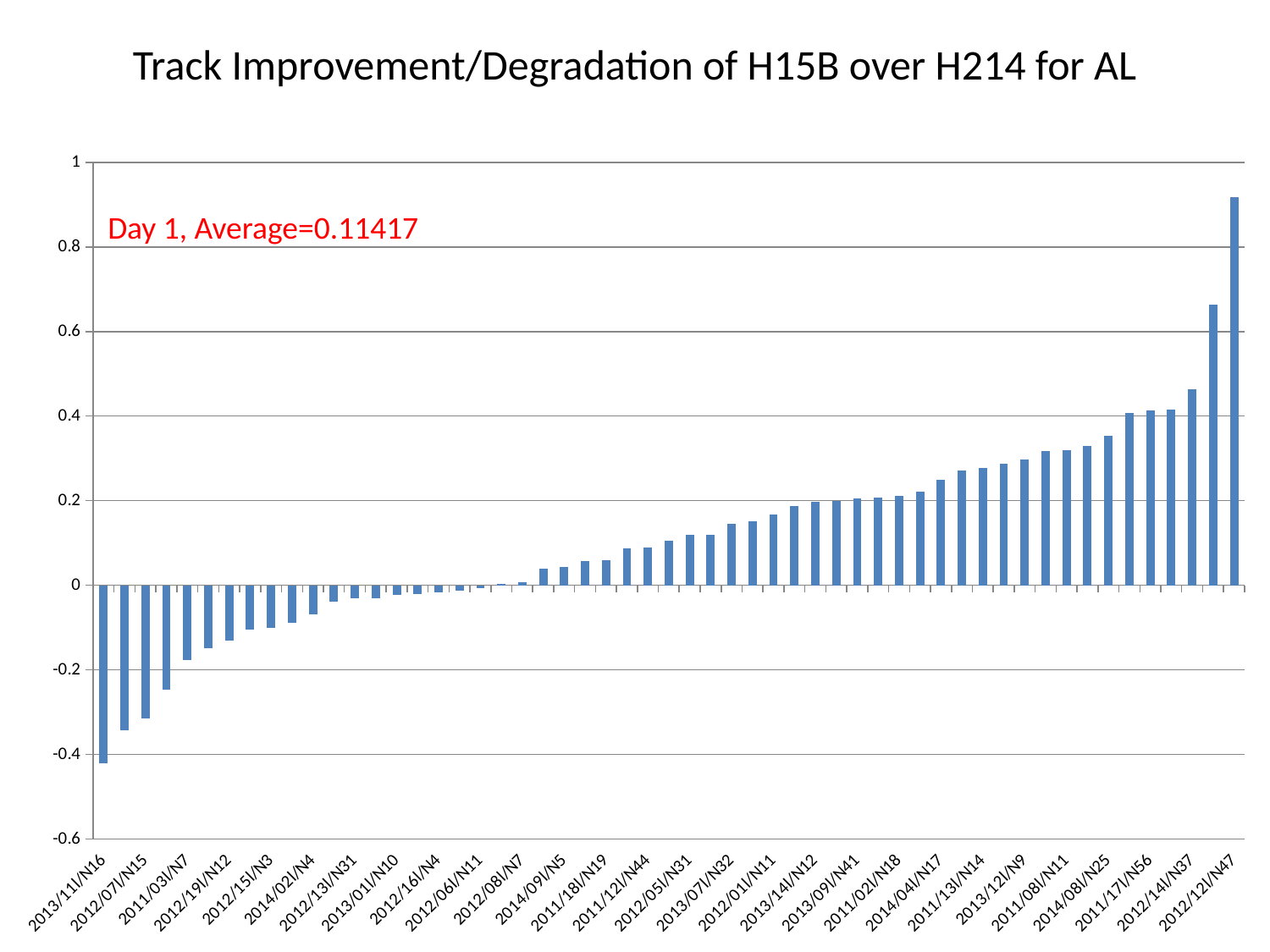
Which category has the lowest value? 2013/11l/N16 What is the title of the chart? Track Improvement/Degradation of H15B over H214 for AL Is the value for 2012/12/N47 greater or less than 0.8? greater Is the value for 2012/07/N15 greater or less than -0.2? less Do the bar values rise or fall from left to right along the x axis? rise Is the value for 2013/11/N16 greater or less than -0.2? less Which category has the highest value? 2012/12l/N47 What average value is stated in the red annotation on the chart? 0.11417 What kind of chart is shown on the slide? bar chart Which is larger, the value for 2013/11/N16 or the value for 2012/12/N47? 2012/12/N47